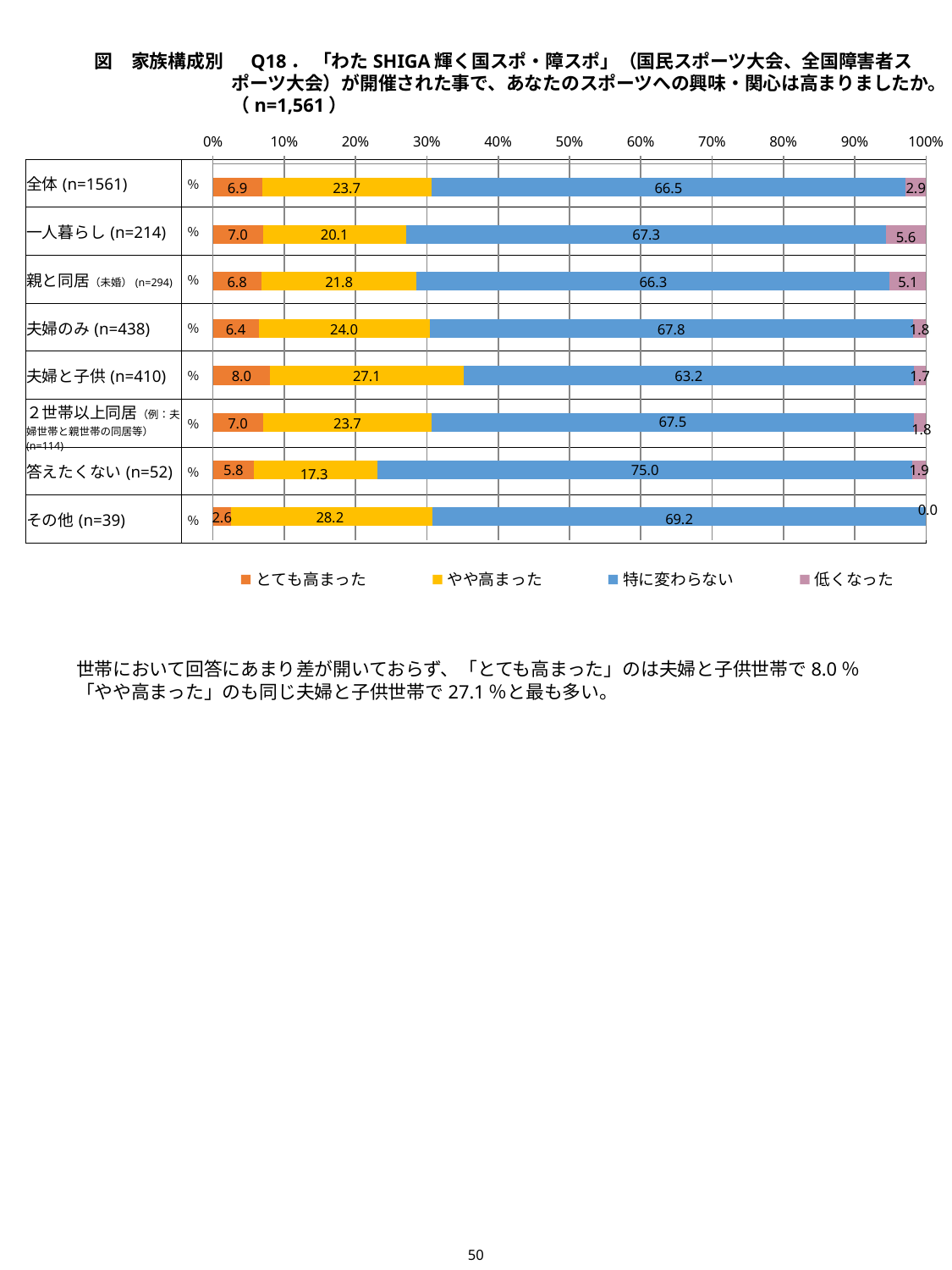
What is the value of 「特に変わらない」 for 全体 (n=1561)? 66.5 How many categories (family composition groups) are shown in the chart? 8 Which is larger: the 「やや高まった」 value for 夫婦のみ (n=438) or for 親と同居（未婚）(n=294)? 夫婦のみ (n=438) How many series does the legend list? 4 What is the value of 「とても高まった」 for 夫婦と子供 (n=410)? 8.0 Which category has the highest value for 「特に変わらない」? 答えたくない (n=52) What is the value of 「やや高まった」 for その他 (n=39)? 28.2 What is the difference between the 「やや高まった」 values for 夫婦と子供 (n=410) and 一人暮らし (n=214)? 7.0 What is the value of 「低くなった」 for 一人暮らし (n=214)? 5.6 What kind of chart is shown on the slide? Stacked bar chart Which category has the lowest value for 「とても高まった」? その他 (n=39) What is the total of the stacked bar for 全体 (n=1561)? 100.0